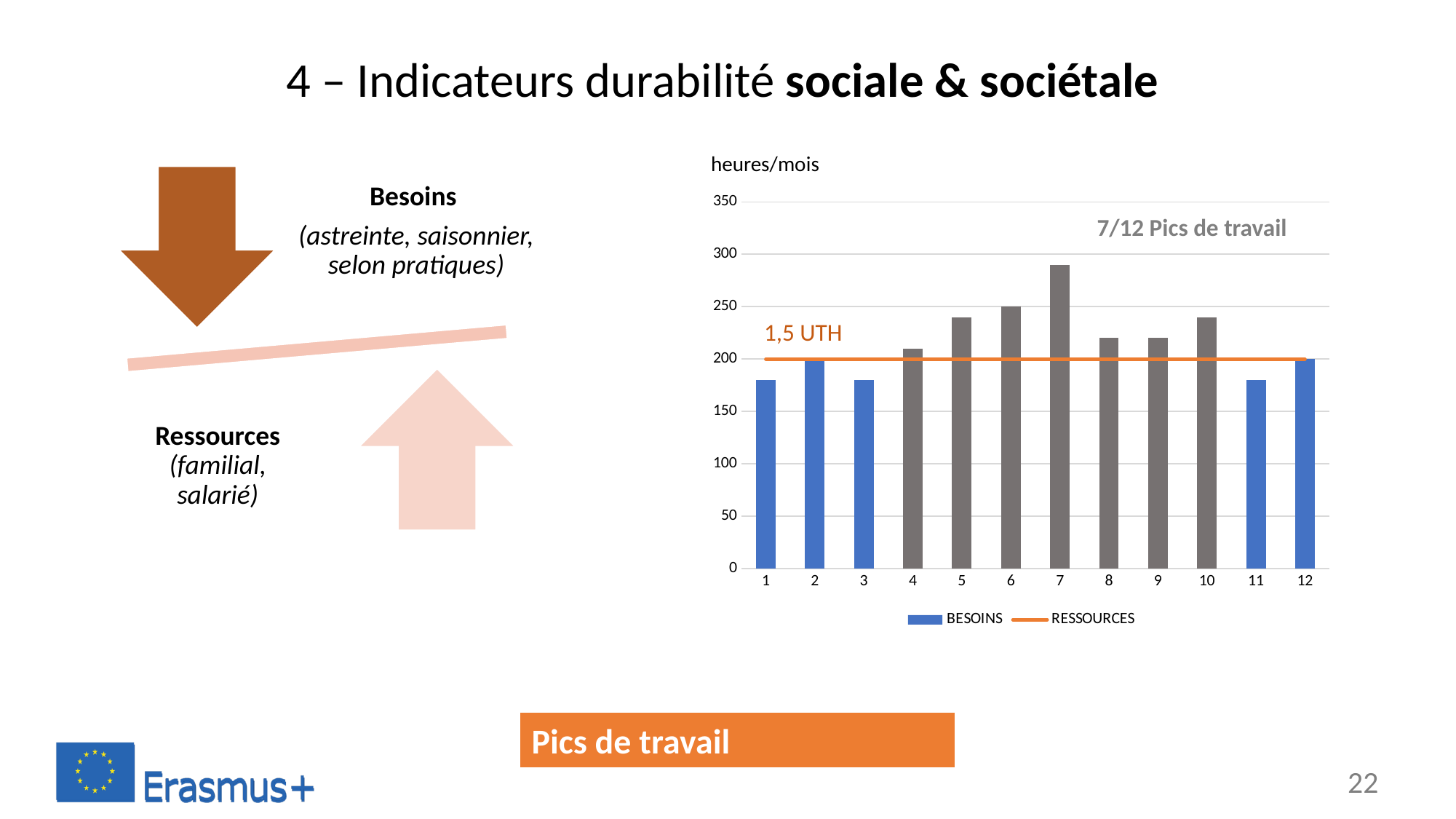
Is the BESOINS value for month 1 greater or less than 200? less Is the BESOINS value for month 11 greater or less than 200? less How many series does the chart legend list? 2 What kind of chart is shown on the slide? bar and line chart How many months (categories) are shown on the x axis of the chart? 12 What unit is written above the y axis of the chart? heures/mois Is the BESOINS value for month 7 greater or less than 250? greater Which month has the highest BESOINS bar? 7 Do the BESOINS bars rise or fall from month 4 to month 7? rise At what value on the y axis does the RESSOURCES line sit? 200 Which month has the larger BESOINS value, month 7 or month 1? 7